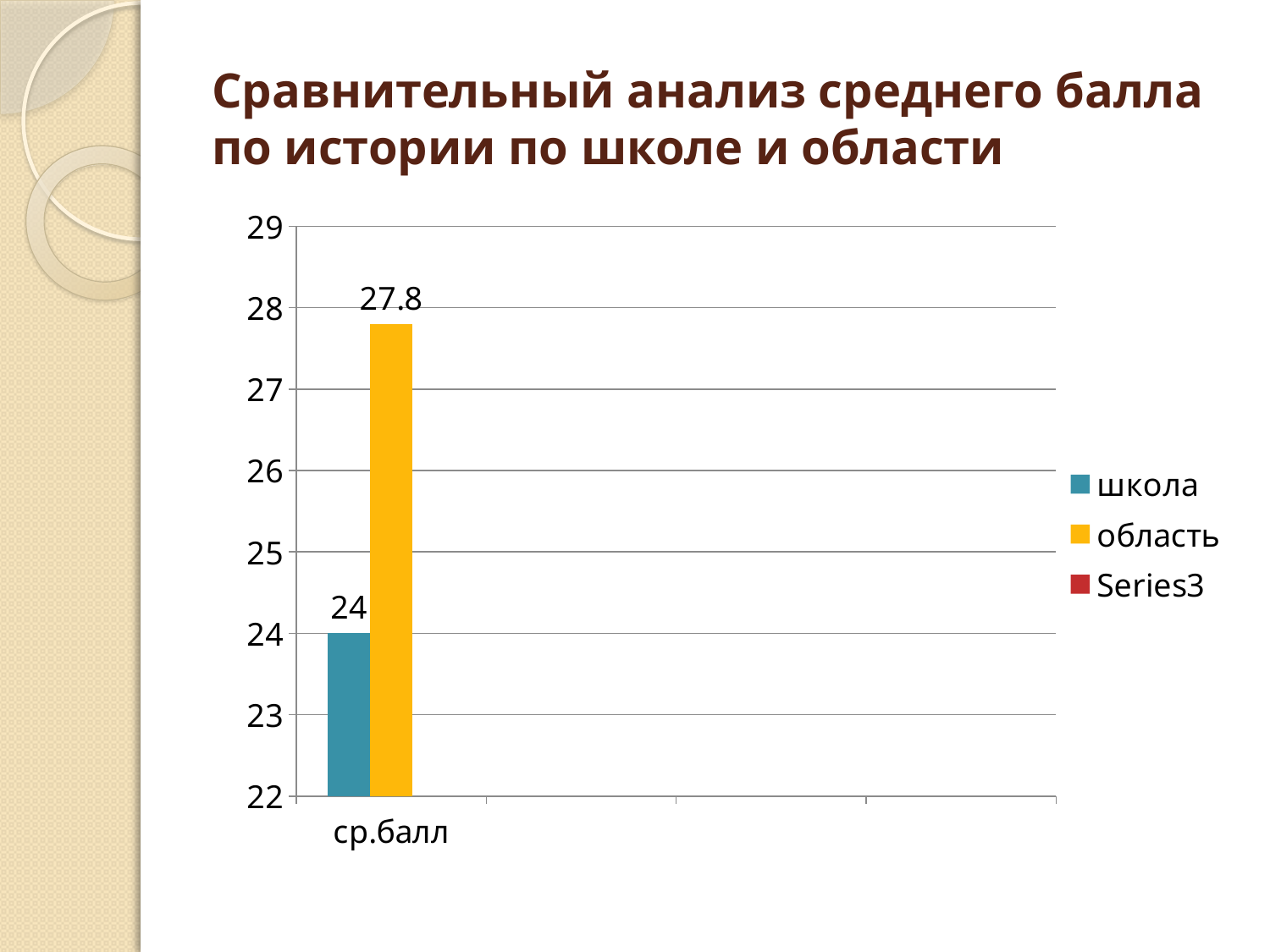
What is the value for школа in the ср.балл category? 24 What colour is the bar for область? yellow What is the value for область in the ср.балл category? 27.8 Which series has the higher value for ср.балл, школа or область? область What is the difference between the область value and the школа value? 3.8 Is the value for школа greater or less than 25? less What is the category label shown on the x axis? ср.балл Which series has the lowest plotted value? школа How many series does the legend list? 3 What kind of chart is shown on the slide? bar chart Is the value for область greater or less than 27? greater What is the highest value shown on the vertical axis? 29